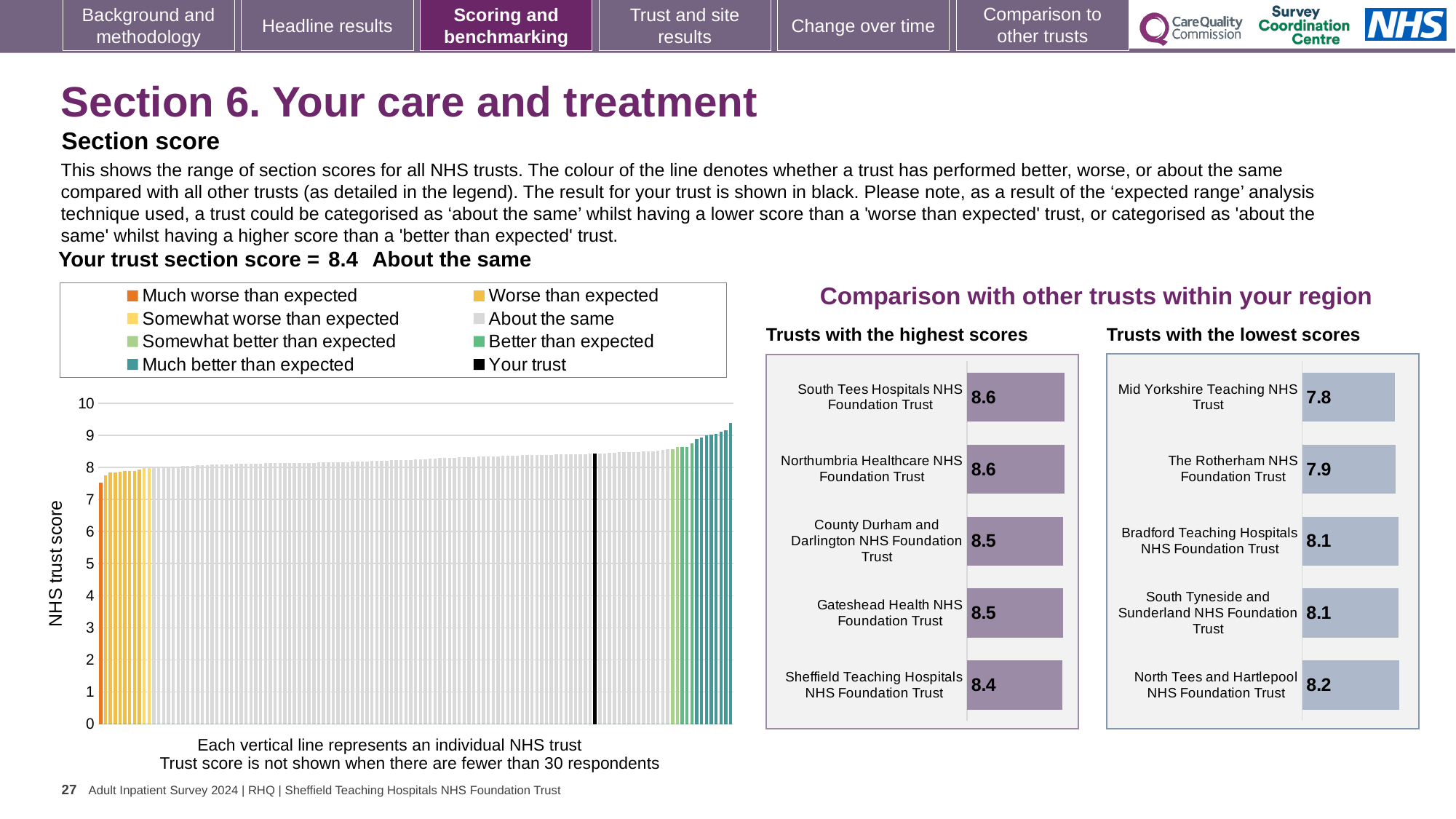
In the 'Trusts with the lowest scores' chart, which has the higher score: The Rotherham NHS Foundation Trust or North Tees and Hartlepool NHS Foundation Trust? North Tees and Hartlepool NHS Foundation Trust In the 'Trusts with the highest scores' chart, what is the score for Sheffield Teaching Hospitals NHS Foundation Trust? 8.4 In the 'Trusts with the lowest scores' chart, what is the difference between the scores of North Tees and Hartlepool NHS Foundation Trust and Mid Yorkshire Teaching NHS Trust? 0.4 What kind of chart is the large 'NHS trust score' chart on the left of the slide? bar chart In the 'Trusts with the highest scores' chart, what is the difference between the scores of South Tees Hospitals NHS Foundation Trust and Sheffield Teaching Hospitals NHS Foundation Trust? 0.2 In the large 'NHS trust score' chart, is the value of the highest (rightmost) bar greater or less than 9? greater According to the slide, what is your trust's section score for Section 6? 8.4 In the 'Trusts with the lowest scores' chart, which trust has the lowest score? Mid Yorkshire Teaching NHS Trust In the 'Trusts with the lowest scores' chart, what is the score for Mid Yorkshire Teaching NHS Trust? 7.8 In the 'Trusts with the highest scores' chart, what is the score for South Tees Hospitals NHS Foundation Trust? 8.6 How many trusts are shown in the 'Trusts with the highest scores' chart? 5 How many entries does the legend of the large 'NHS trust score' chart list? 8